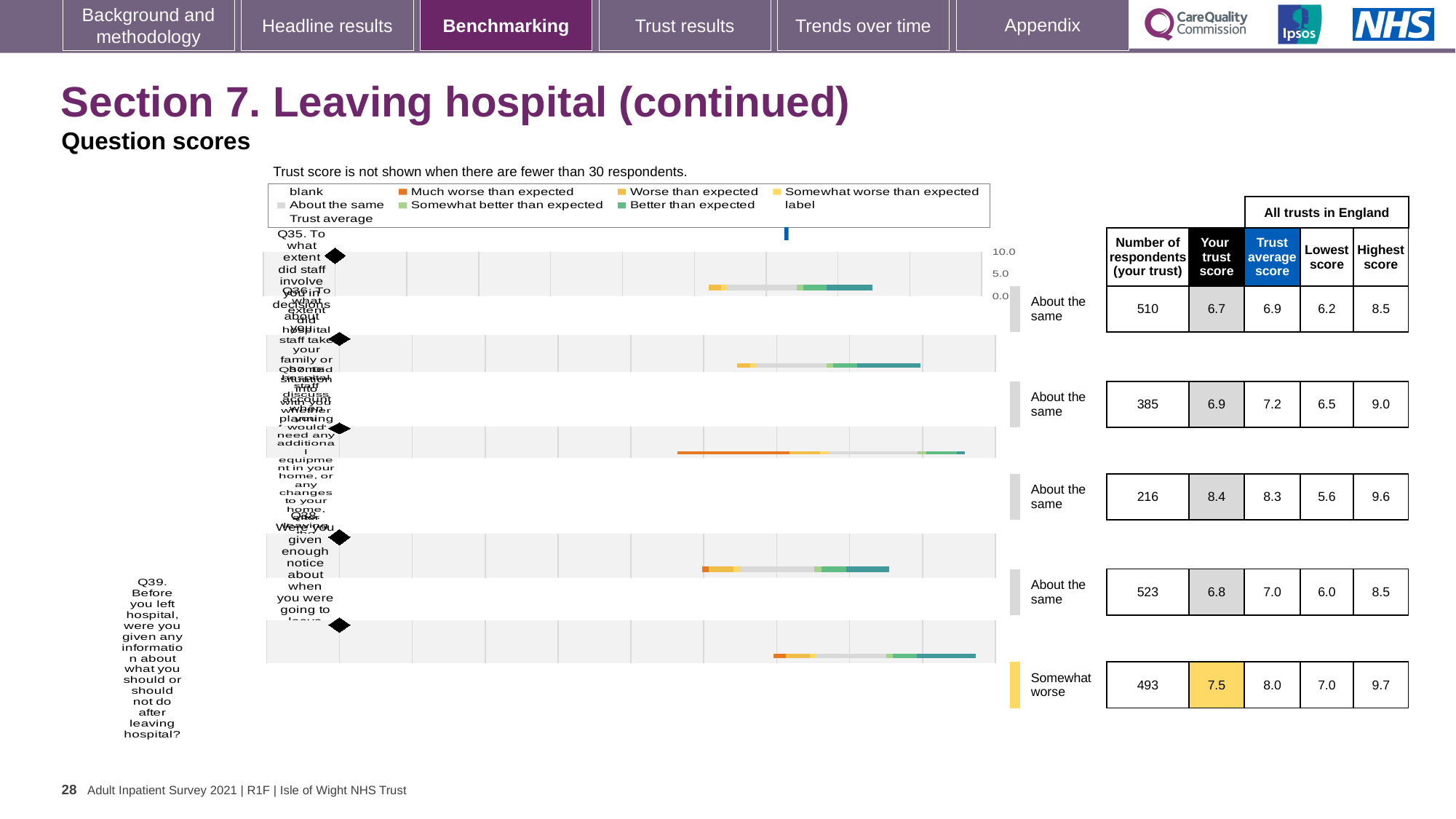
What kind of chart is used to show the question scores on this slide? bar chart For Q35, which is larger: the trust's score or the trust average score? Trust average score What is the highest score among all trusts in England for Q39? 9.7 Which question is rated 'Somewhat worse' than expected? Q39 What is the number of respondents for Q39 (information about what you should or should not do after leaving hospital)? 493 What is the trust's score for Q39? 7.5 What is the lowest score among all trusts in England for Q39? 7.0 What is the number of respondents for Q35, the first question row? 510 How many question rows are shown in the benchmarking chart and table? 5 What is the difference between the trust average score and the trust's own score for Q39? 0.5 What is the trust average score for all trusts in England for Q39? 8.0 What is the trust's score for Q35, the first question row? 6.7